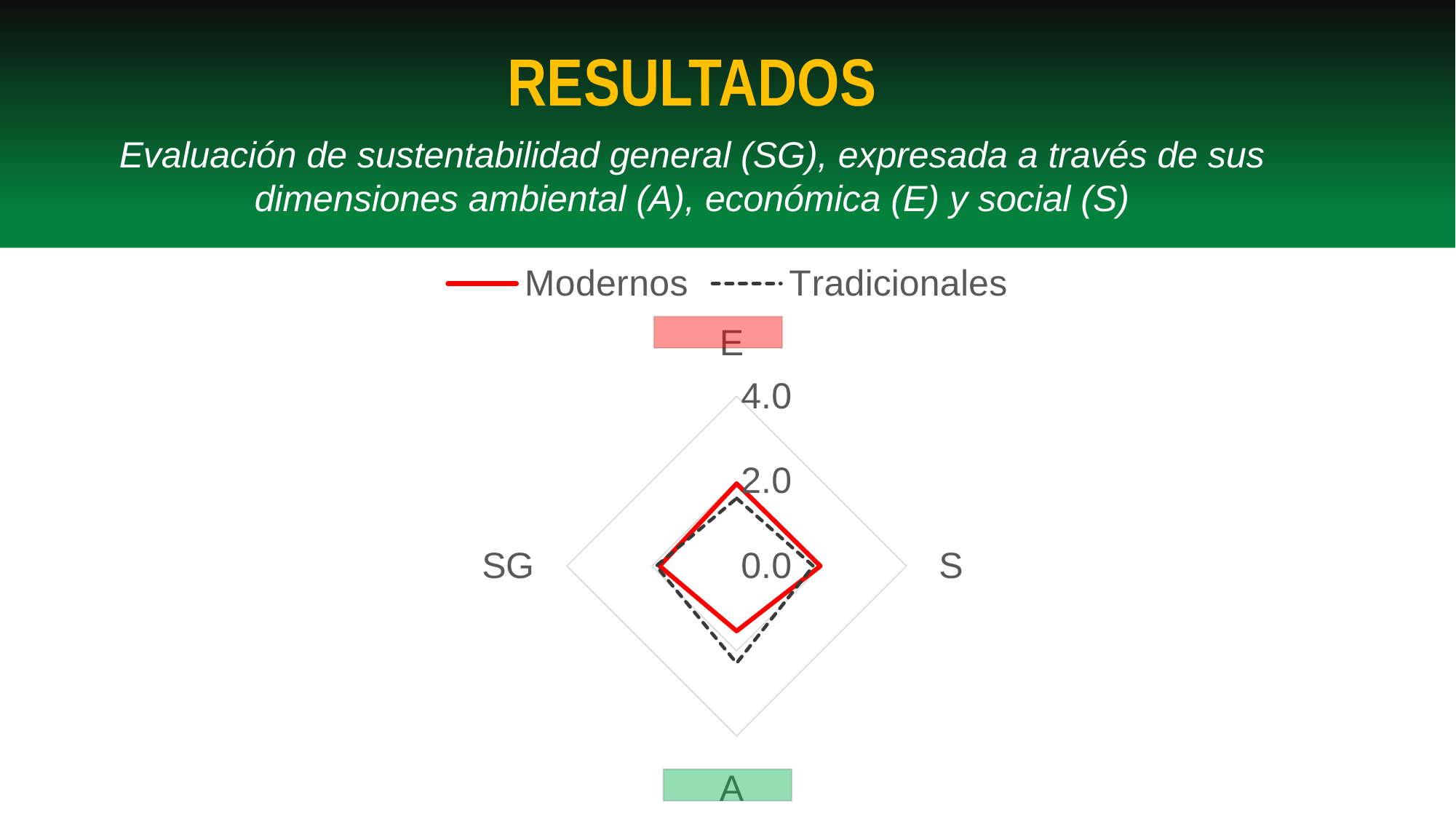
On the E axis, which series has the larger value, Modernos or Tradicionales? Modernos On the A axis, which series has the larger value, Modernos or Tradicionales? Tradicionales On which axis does the Tradicionales series reach its highest value? A How many series does the legend list? 2 Is the value for Modernos on the A axis greater or less than 2.0? less How many axes (categories) does the radar chart have? 4 Which series is drawn with a dashed line? Tradicionales Is the value for Tradicionales on the E axis greater or less than 2.0? less What kind of chart is shown on the slide? Radar chart Which series is drawn with a red solid line? Modernos On which axis does the Modernos series have its lowest value? A Is the value for Tradicionales on the A axis greater or less than 4.0? less